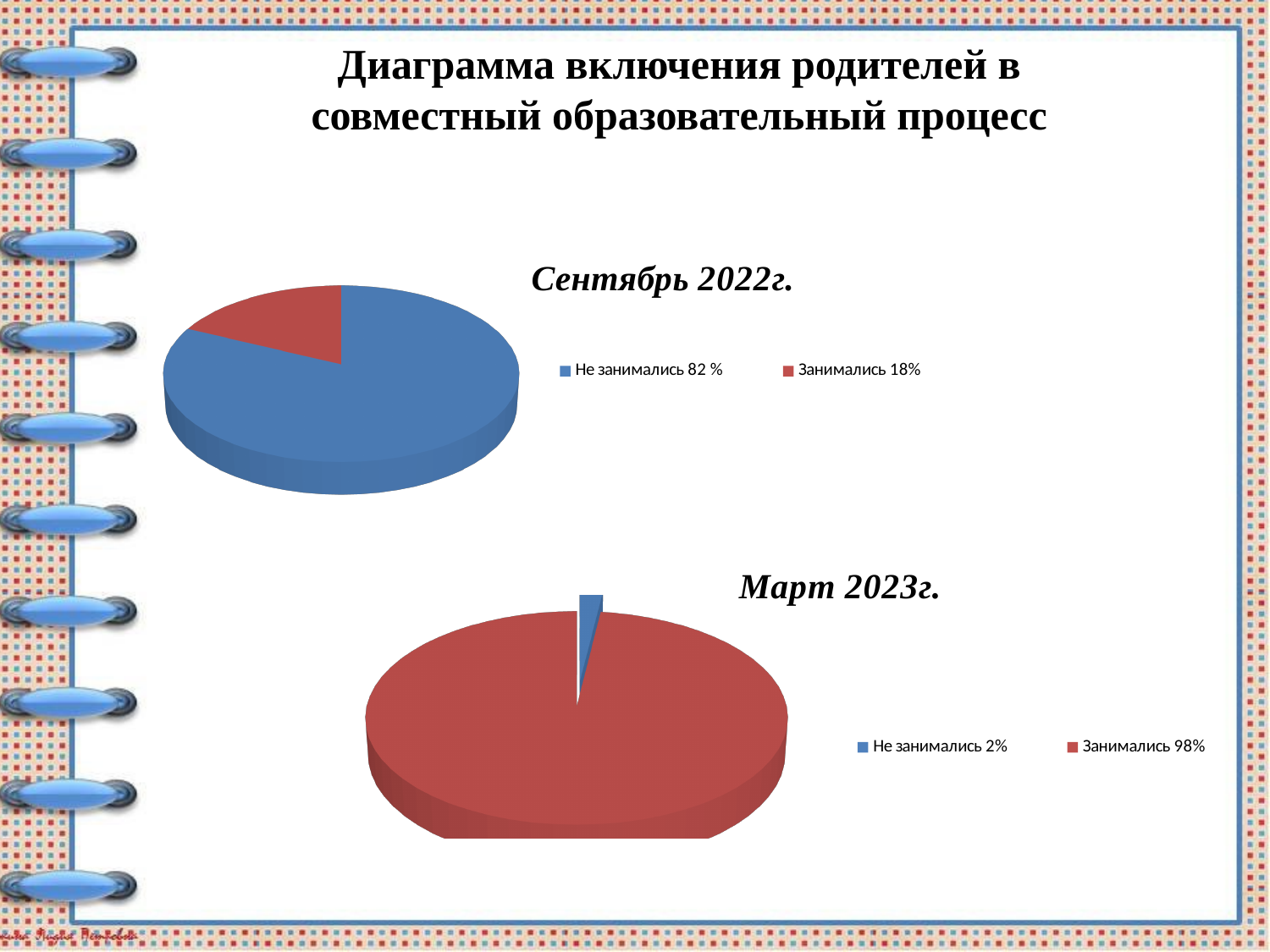
What type of chart is used for the Сентябрь 2022г. data? pie chart In the Сентябрь 2022г. chart, what share is shown for Не занимались? 82 % In the Март 2023г. chart, what share is shown for Занимались? 98% How many slices does the Март 2023г. pie chart have? 2 In the Сентябрь 2022г. chart, what share is shown for Занимались? 18% In the Март 2023г. chart, which category has the smallest slice? Не занимались In the Март 2023г. chart, what share is shown for Не занимались? 2% How many entries does the legend of the Сентябрь 2022г. chart list? 2 In the Сентябрь 2022г. chart, what is the difference between the Не занимались and Занимались shares? 64 percentage points In the Сентябрь 2022г. chart, which category has the largest slice? Не занимались In the Март 2023г. chart, which is larger: Занимались or Не занимались? Занимались In the Март 2023г. chart, what colour is the Занимались slice? red